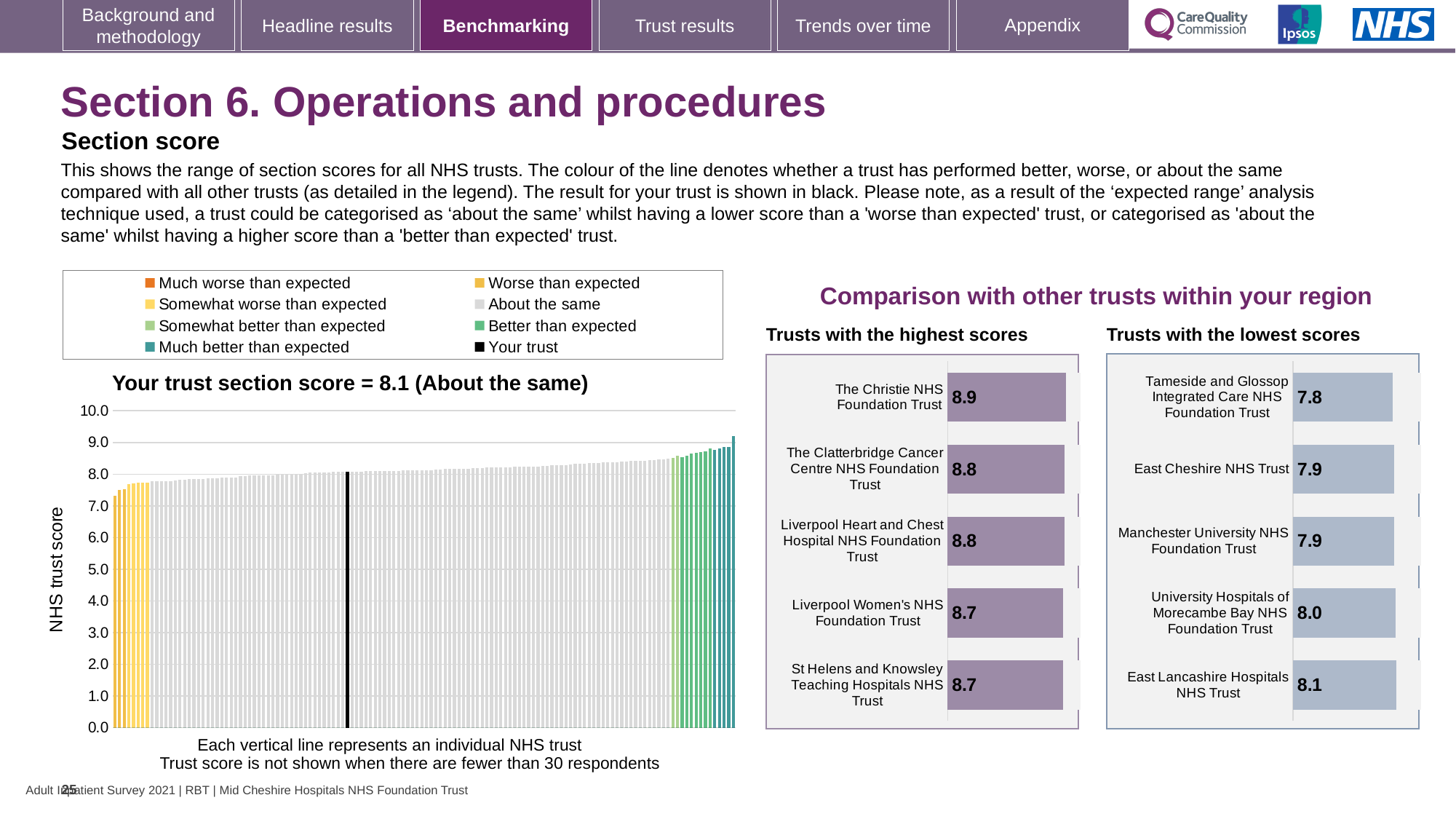
How many entries does the legend above the 'Your trust section score' chart list? 8 In the 'Your trust section score' chart, do the bar heights rise or fall from left to right? rise In the 'Trusts with the highest scores' chart, what is the score for The Christie NHS Foundation Trust? 8.9 In the 'Trusts with the highest scores' chart, which has the larger score: The Christie NHS Foundation Trust or St Helens and Knowsley Teaching Hospitals NHS Trust? The Christie NHS Foundation Trust In the 'Trusts with the lowest scores' chart, what is the difference between the scores of East Lancashire Hospitals NHS Trust and Tameside and Glossop Integrated Care NHS Foundation Trust? 0.3 What is the y-axis label of the 'Your trust section score' chart? NHS trust score In the 'Trusts with the lowest scores' chart, what is the score for Tameside and Glossop Integrated Care NHS Foundation Trust? 7.8 In the 'Trusts with the lowest scores' chart, which trust has the lowest score? Tameside and Glossop Integrated Care NHS Foundation Trust What kind of chart is the 'Your trust section score' chart? bar chart How many trusts are shown in the 'Trusts with the highest scores' chart? 5 In the 'Your trust section score' chart, what is the section score for your trust? 8.1 In the 'Trusts with the highest scores' chart, which trust has the highest score? The Christie NHS Foundation Trust